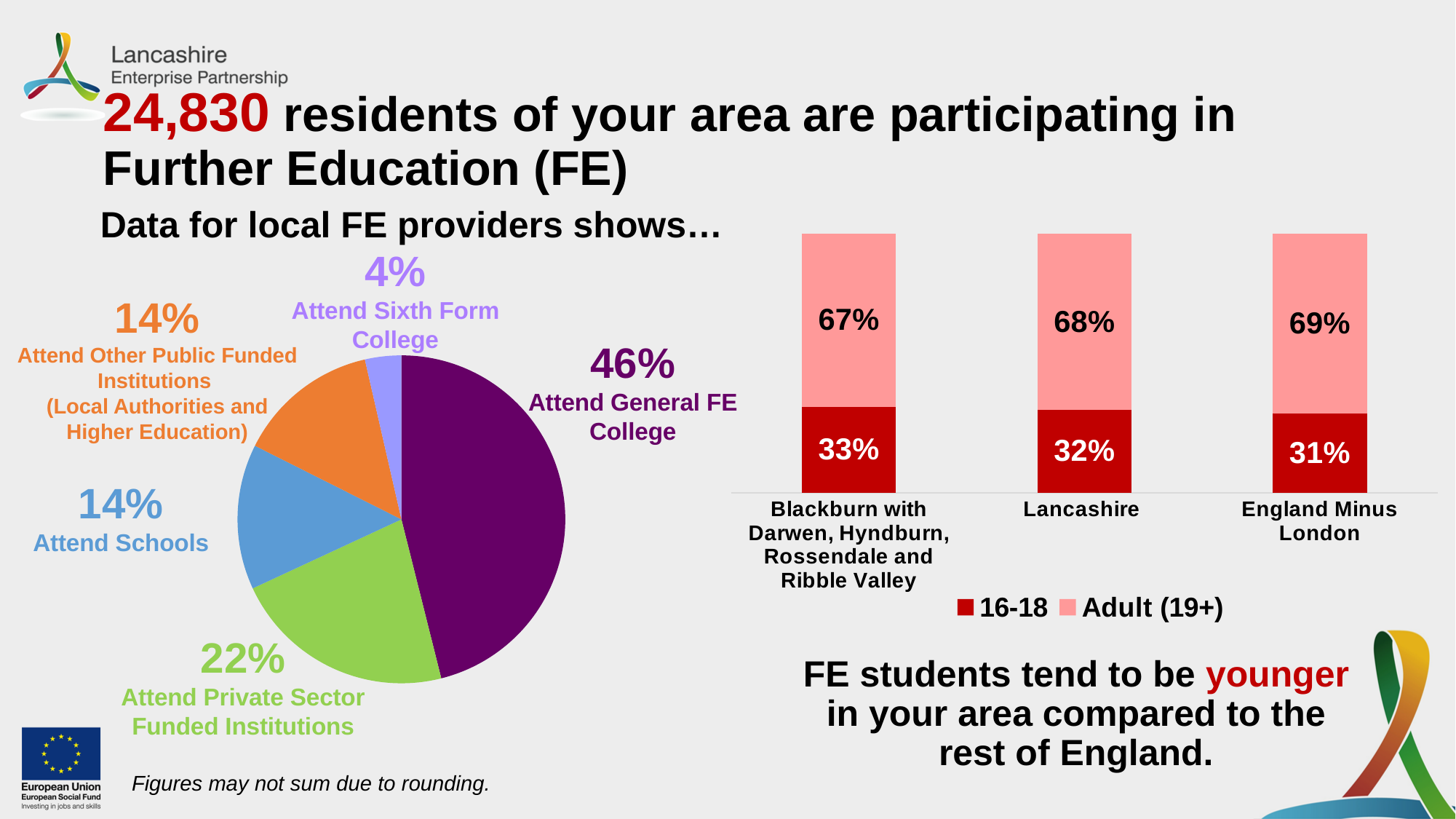
In the pie chart on the left, how many slices are there? 5 In the pie chart on the left, which category has the largest share? Attend General FE College In the stacked bar chart on the right, which area has the highest 16-18 share? Blackburn with Darwen, Hyndburn, Rossendale and Ribble Valley In the stacked bar chart on the right, how many series does the legend list? 2 In the pie chart on the left, what is the difference between the share attending General FE College and the share attending Private Sector Funded Institutions? 24% What kind of chart is shown on the right of the slide? Stacked bar chart In the pie chart on the left, what share of FE students attend Sixth Form College? 4% In the stacked bar chart on the right, what is the total of the Lancashire bar? 100% In the stacked bar chart on the right, what is the Adult (19+) value for England Minus London? 69% In the stacked bar chart on the right, what is the 16-18 value for Lancashire? 32% In the pie chart on the left, which category has the smallest share? Attend Sixth Form College In the pie chart on the left, what share of FE students attend General FE College? 46%